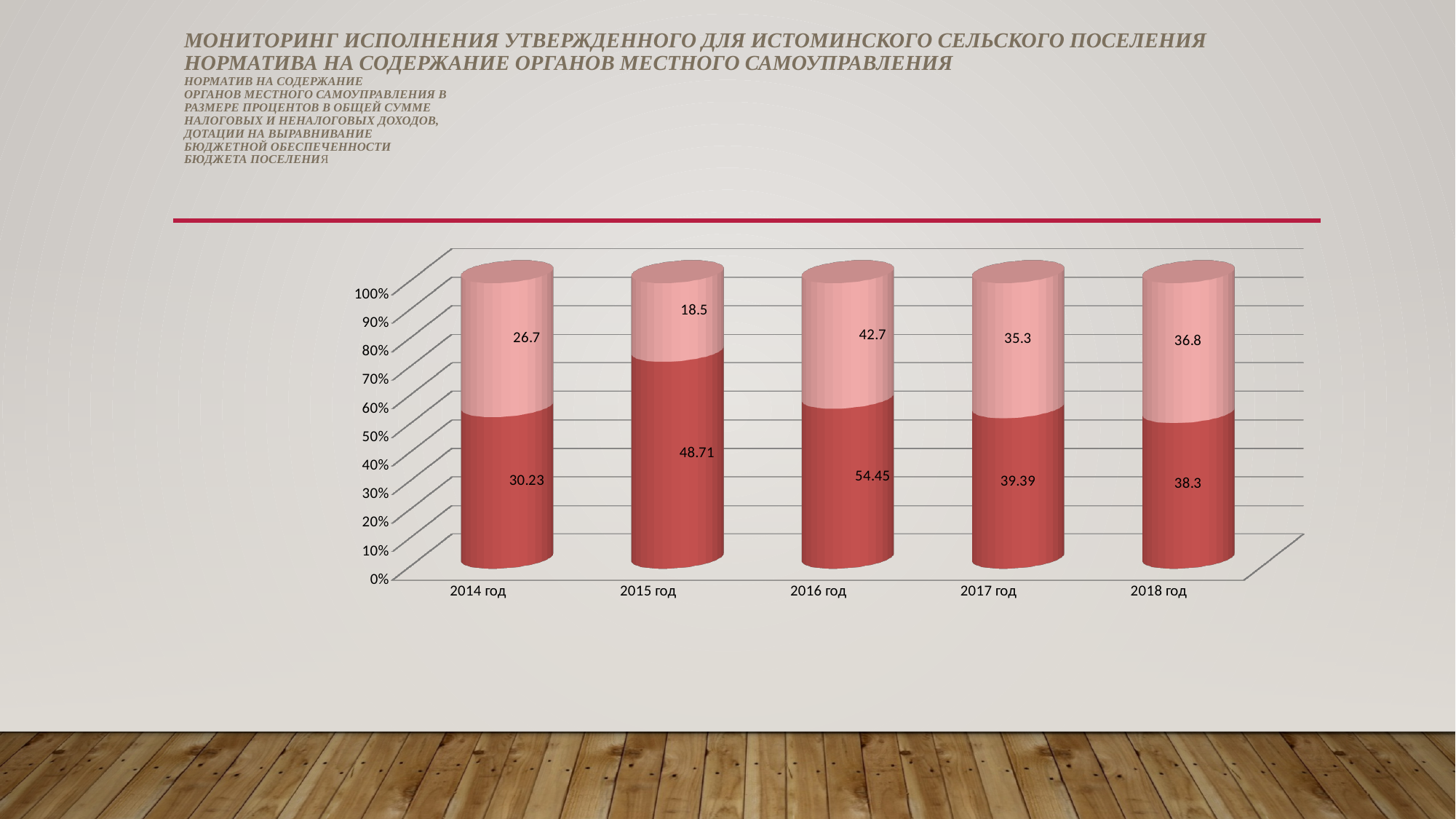
Which is larger: the light pink segment value for 2017 год or for 2018 год? 2018 год What value is shown for the dark red (lower) segment of the 2014 год bar? 30.23 What is the difference between the dark red segment values for 2016 год and 2014 год? 24.22 What kind of chart is shown on the slide? Stacked bar chart What value is shown for the dark red (lower) segment of the 2016 год bar? 54.45 What is the highest percentage tick shown on the vertical axis? 100% Which year has the highest value in the dark red (lower) segment? 2016 год Which year has the lowest value in the light pink (upper) segment? 2015 год Does the dark red segment value rise or fall from 2016 год to 2018 год? Fall What value is shown for the light pink (upper) segment of the 2015 год bar? 18.5 How many years (categories) are shown on the x axis? 5 What value is shown for the light pink (upper) segment of the 2018 год bar? 36.8